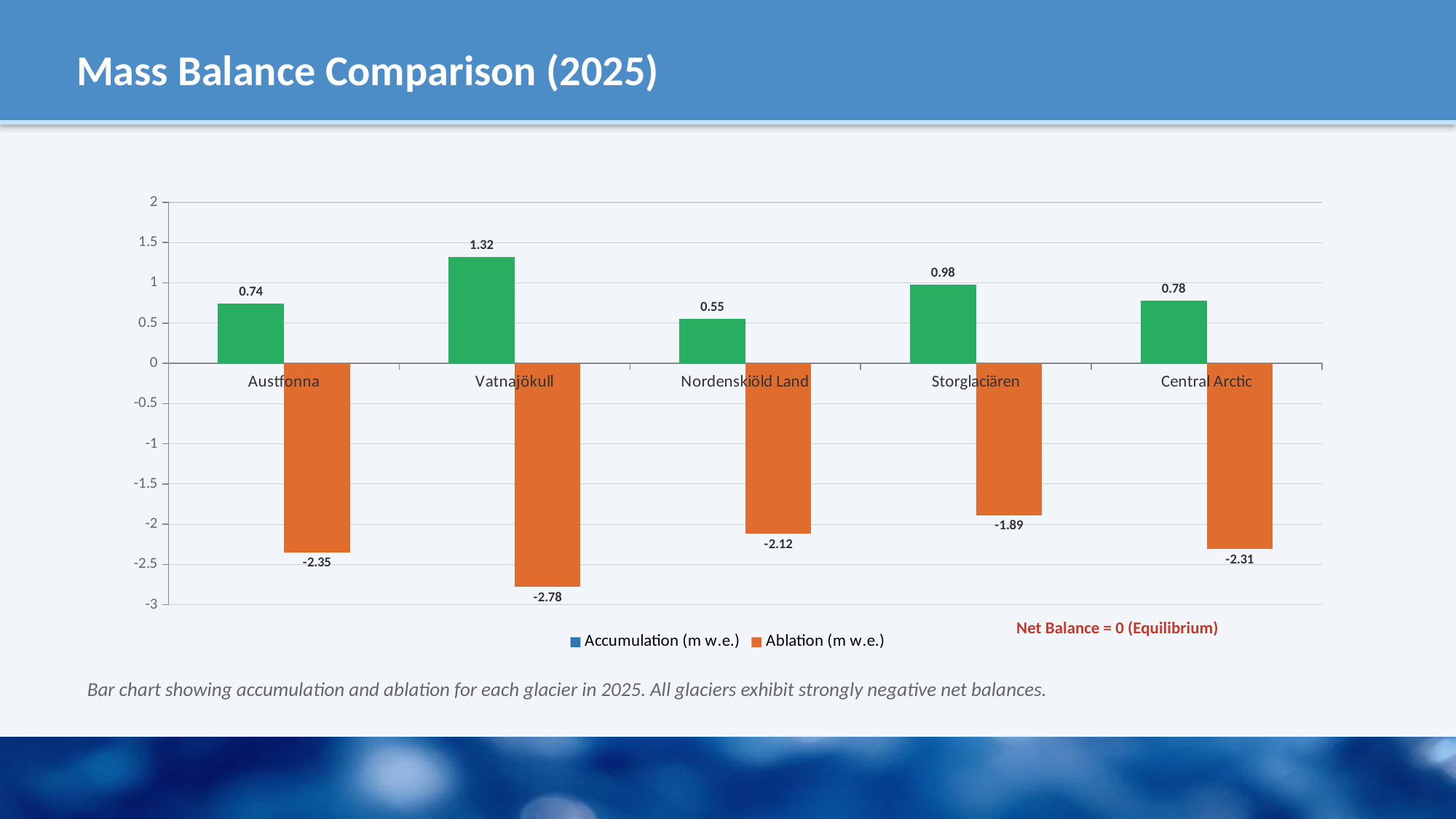
How many glaciers are shown on the x axis? 5 What kind of chart is shown on the slide? Bar chart Which glacier has the most negative Ablation value? Vatnajökull What is the title of the chart on the slide? Mass Balance Comparison (2025) What is the Ablation value for Storglaciären? -1.89 Which glacier has the highest Accumulation value? Vatnajökull What is the Accumulation value for Vatnajökull? 1.32 Which glacier has the lowest Accumulation value? Nordenskiöld Land How many series does the legend list? 2 Which has a larger Accumulation value, Storglaciären or Central Arctic? Storglaciären What is the difference between the Accumulation values of Vatnajökull and Austfonna? 0.58 What is the Ablation value for Nordenskiöld Land? -2.12